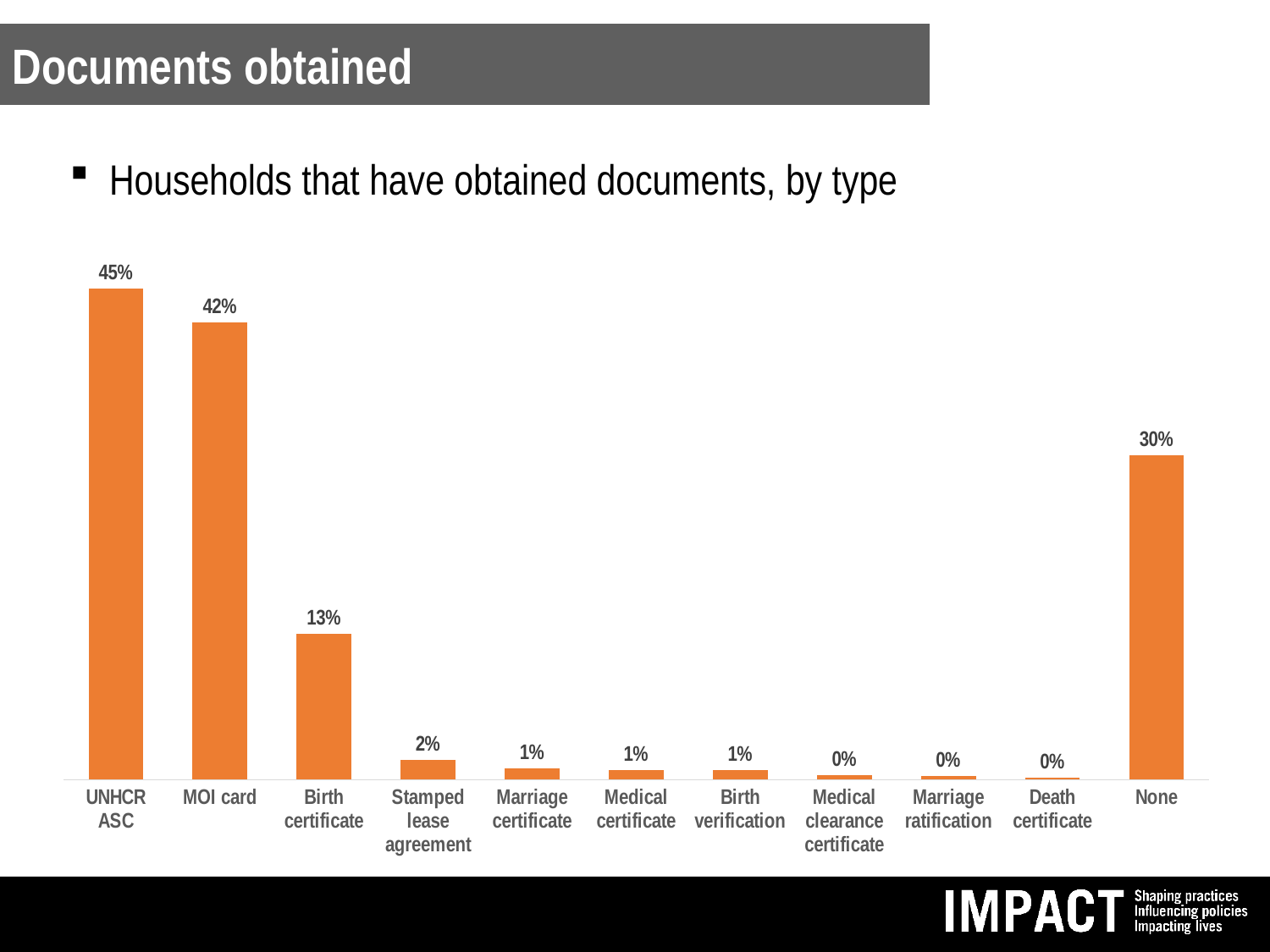
What colour are the bars in the chart? Orange What percentage of households obtained a birth certificate? 13% What percentage of households obtained no documents (None)? 30% What kind of chart is shown on the slide? Bar chart What is the difference in percentage points between None and Birth certificate? 17% How many document categories are shown on the x axis? 11 What percentage of households obtained a stamped lease agreement? 2% What is the difference in percentage points between UNHCR ASC and MOI card? 3% What percentage of households obtained a UNHCR ASC? 45% What percentage of households obtained a MOI card? 42% Which is larger, the value for MOI card or the value for None? MOI card Which document type has the highest percentage of households? UNHCR ASC